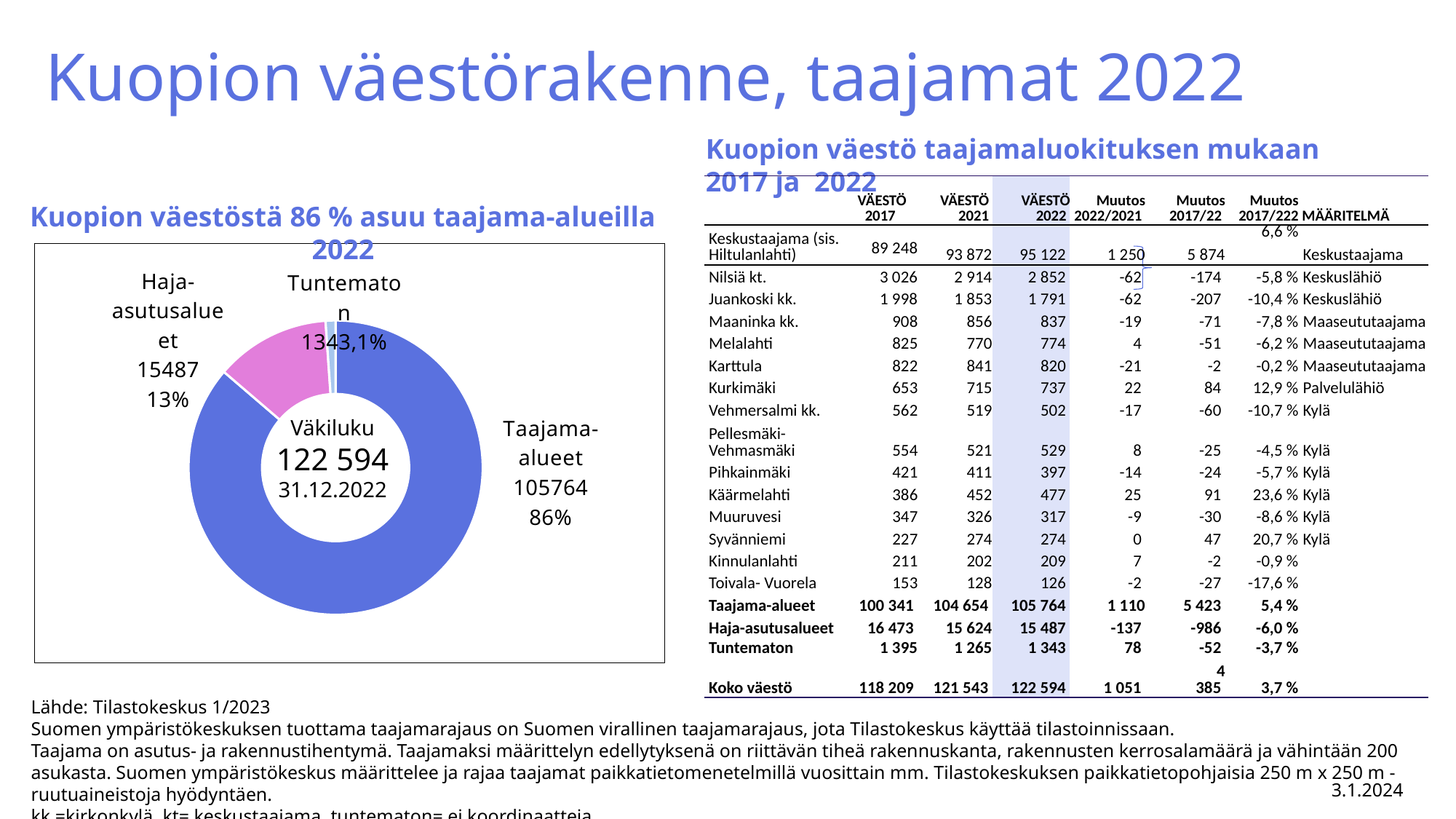
Which is larger in the doughnut chart, Haja-asutusalueet or Tuntematon? Haja-asutusalueet What share of the doughnut chart does Taajama-alueet represent? 86% What is the value for Taajama-alueet in the doughnut chart? 105764 What total population (Väkiluku) is shown in the centre of the doughnut chart? 122 594 What is the value for Haja-asutusalueet in the doughnut chart? 15487 Which category has the largest slice in the doughnut chart? Taajama-alueet What type of chart is shown on the slide? Doughnut chart What is the difference between the values for Taajama-alueet and Haja-asutusalueet in the doughnut chart? 90277 Which category has the smallest slice in the doughnut chart? Tuntematon What share of the doughnut chart does Haja-asutusalueet represent? 13% How many categories are shown in the doughnut chart? 3 What is the title of the doughnut chart? Kuopion väestöstä 86 % asuu taajama-alueilla 2022